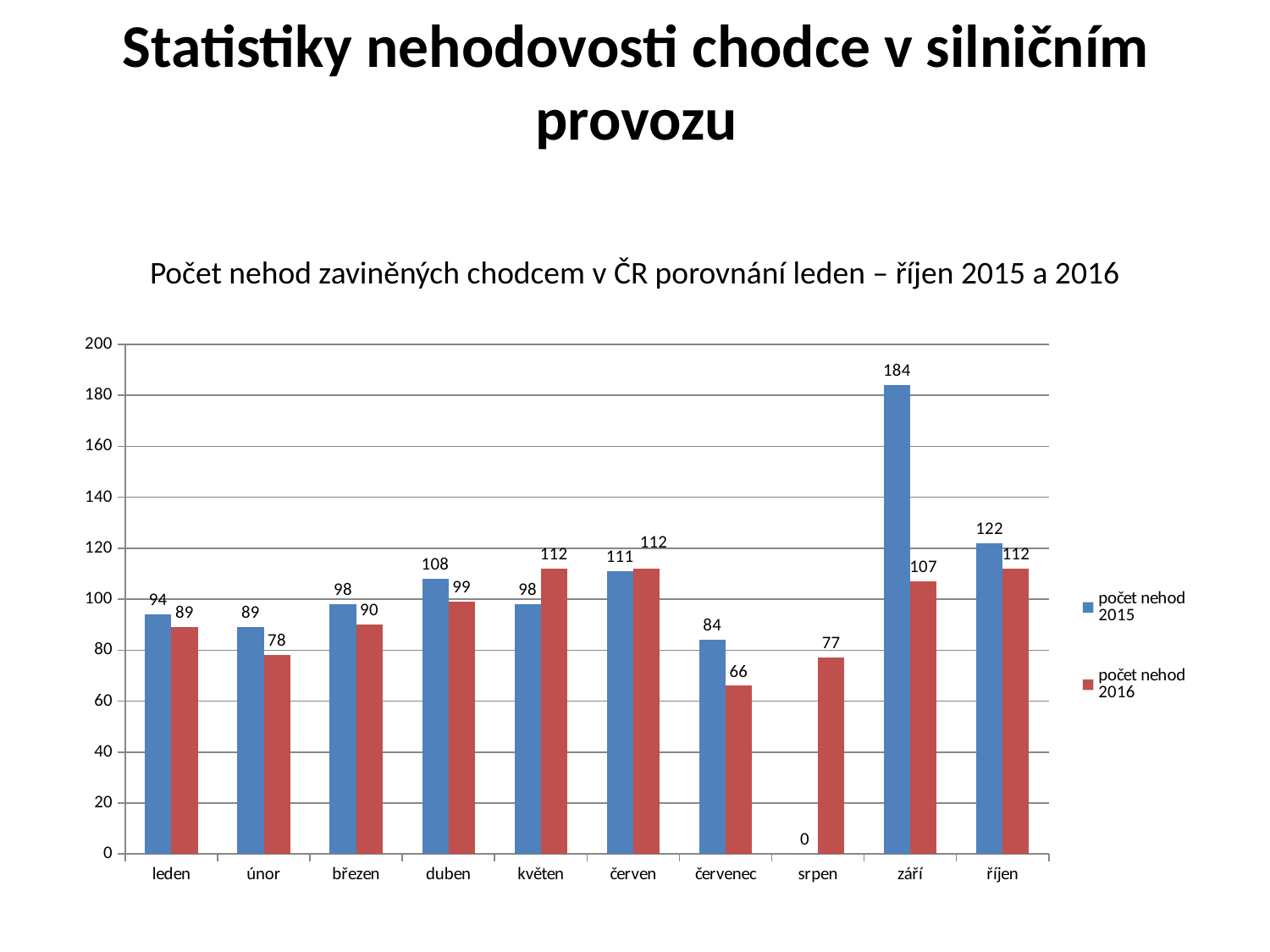
What is the value for počet nehod 2015 in září? 184 What kind of chart is shown on the slide? bar chart Which month has the highest value for počet nehod 2015? září What is the difference between počet nehod 2015 and počet nehod 2016 in září? 77 How many series does the legend list? 2 What is the value for počet nehod 2016 in červenec? 66 What is the title of the chart? Počet nehod zaviněných chodcem v ČR porovnání leden – říjen 2015 a 2016 Which is larger in květen: počet nehod 2015 or počet nehod 2016? počet nehod 2016 What is the difference between počet nehod 2015 in říjen and počet nehod 2015 in leden? 28 Which month has the lowest value for počet nehod 2016? červenec What is the value for počet nehod 2015 in srpen? 0 How many months are shown on the x axis? 10